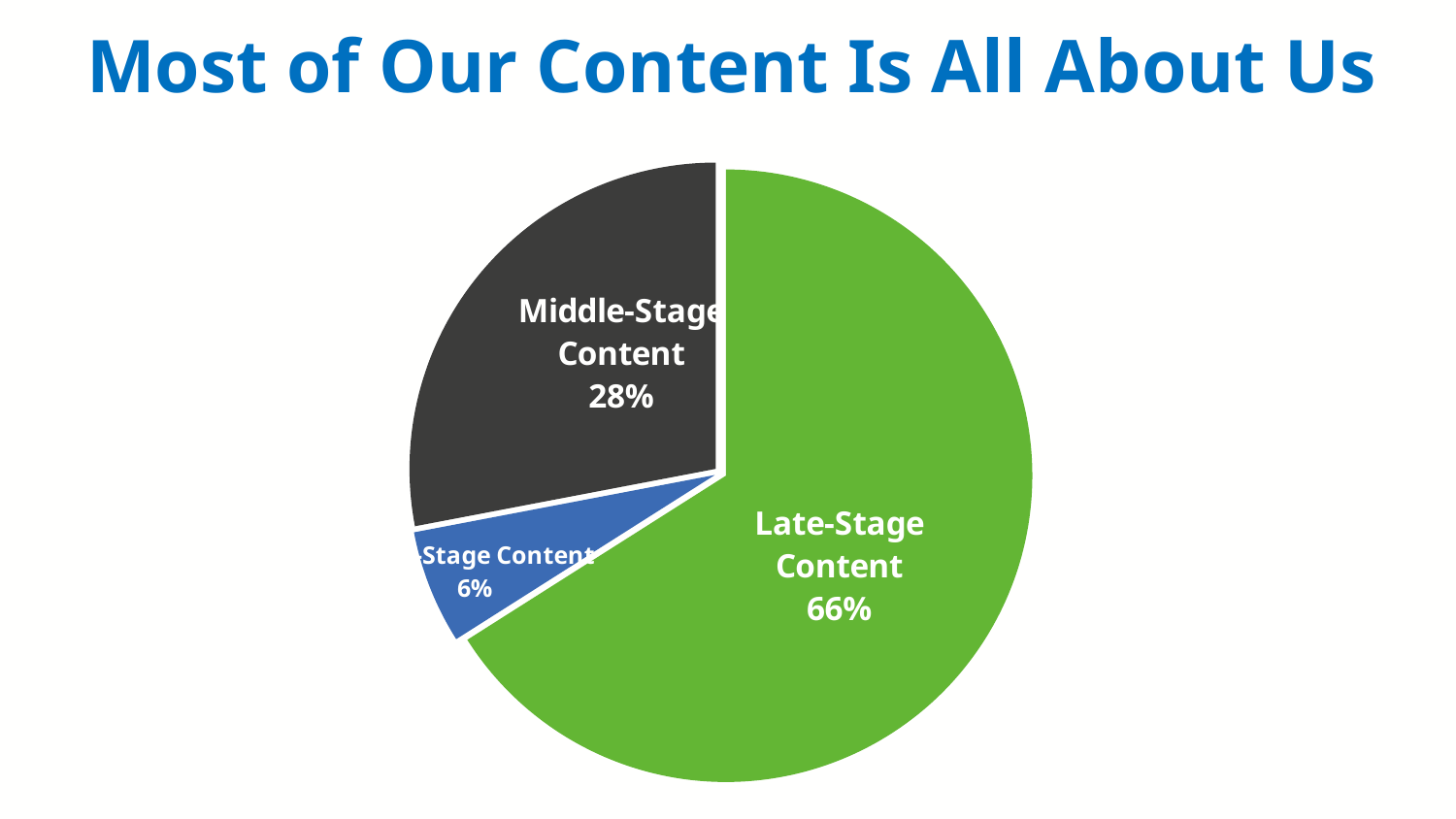
What kind of chart is shown on the slide? pie chart Which is larger, the share for Late-Stage Content or the share for Middle-Stage Content? Late-Stage Content What percentage is shown on the blue slice of the pie? 6% Which slice of the pie is the smallest? the blue slice (6%) What is the difference in percentage points between Late-Stage Content and Middle-Stage Content? 38 What share of the pie does Late-Stage Content have? 66% What colour is the Late-Stage Content slice? green What is the title of the slide? Most of Our Content Is All About Us How many slices does the pie chart have? 3 Which category has the largest slice of the pie? Late-Stage Content What is the difference in percentage points between Middle-Stage Content and the blue slice? 22 What share of the pie does Middle-Stage Content have? 28%